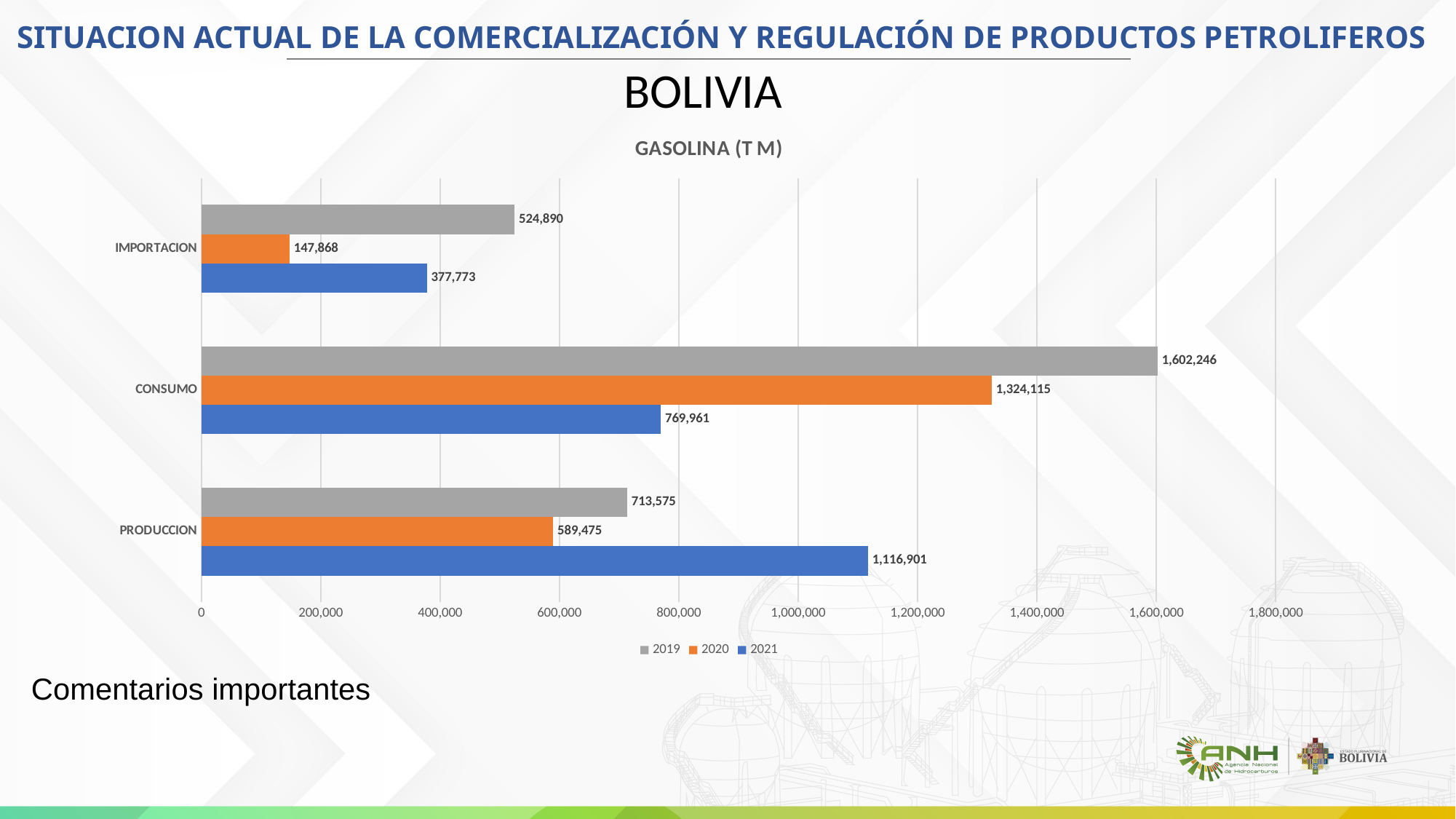
How many categories are shown on the chart? 3 Which category has the lowest 2020 value? IMPORTACION What kind of chart is shown on the slide? bar chart Which is larger for PRODUCCION, the 2020 value or the 2021 value? 2021 Is the 2021 value for CONSUMO greater or less than 800,000? less What is the 2019 value for CONSUMO in the GASOLINA (T M) chart? 1,602,246 What is the difference between the 2021 and 2019 values for PRODUCCION? 403,326 What is the difference between the 2019 and 2020 values for CONSUMO? 278,131 What is the 2021 value for PRODUCCION? 1,116,901 How many series does the legend list? 3 Which category has the highest 2019 value? CONSUMO What is the 2020 value for IMPORTACION? 147,868